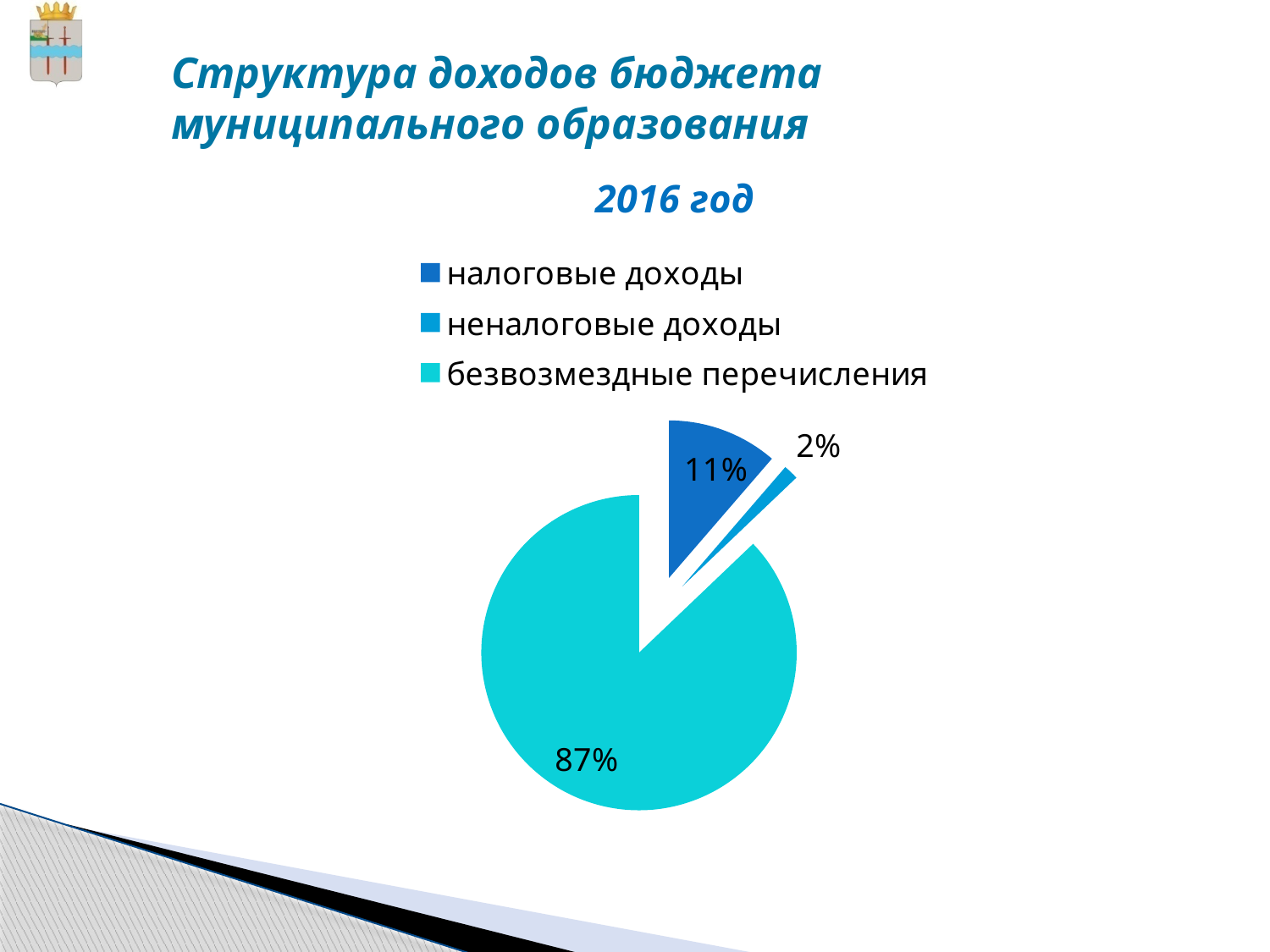
What share of the pie does 'налоговые доходы' have? 11% What year is shown in the chart title? 2016 год What share of the pie does 'неналоговые доходы' have? 2% What share of the pie does 'безвозмездные перечисления' have? 87% Which is larger: 'налоговые доходы' or 'неналоговые доходы'? налоговые доходы What is the combined share of 'налоговые доходы' and 'неналоговые доходы'? 13% What is the difference in percentage points between 'безвозмездные перечисления' and 'налоговые доходы'? 76 What kind of chart is shown on the slide? pie chart How many entries does the legend list? 3 Which category has the largest slice of the pie? безвозмездные перечисления How many slices does the pie chart have? 3 Which category has the smallest slice of the pie? неналоговые доходы